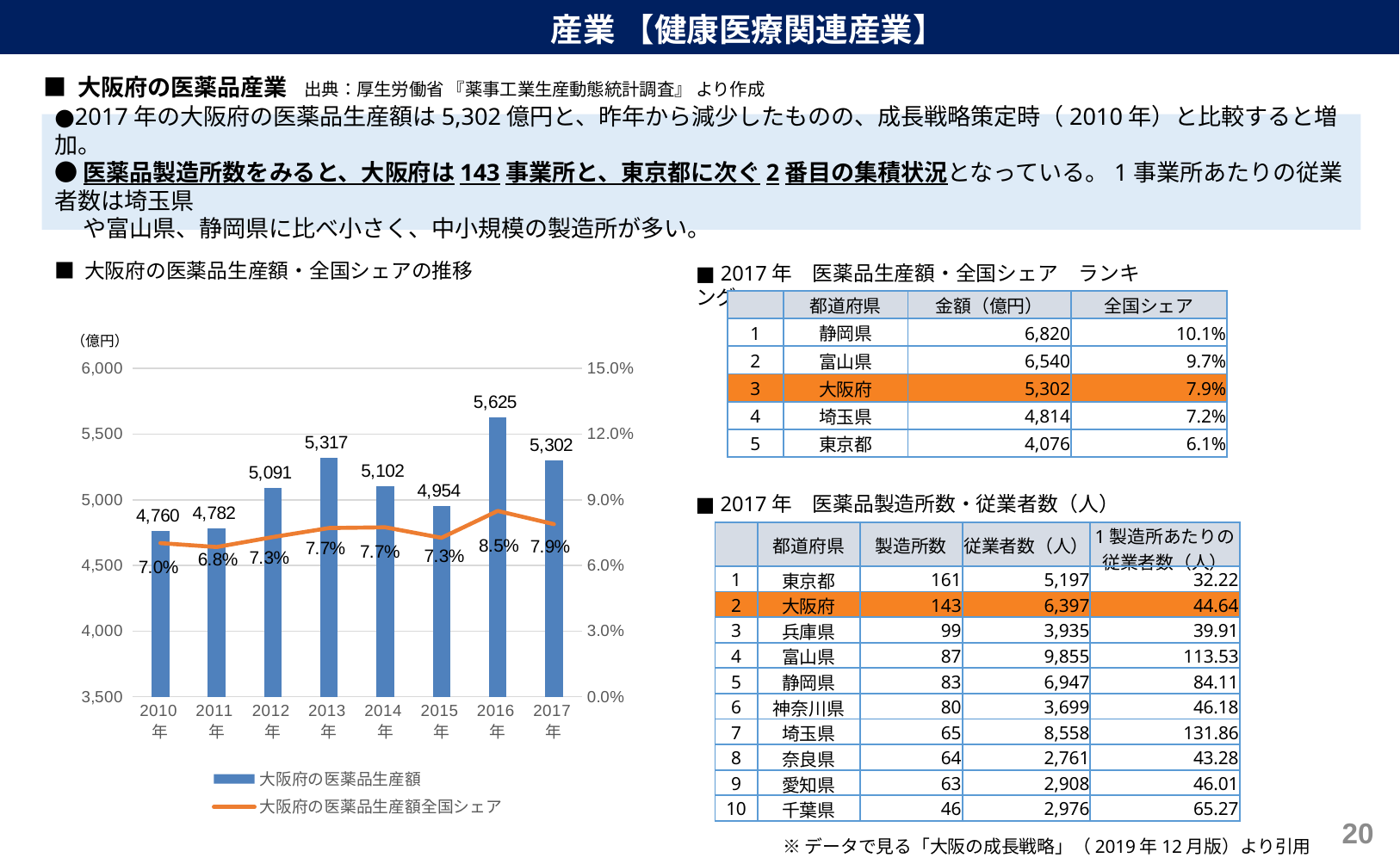
In the chart 大阪府の医薬品生産額・全国シェアの推移, what kind of chart is used for 大阪府の医薬品生産額? bar chart In the chart 大阪府の医薬品生産額・全国シェアの推移, what unit is shown above the left axis? 億円 In the chart 大阪府の医薬品生産額・全国シェアの推移, which year has the highest 大阪府の医薬品生産額? 2016年 In the chart 大阪府の医薬品生産額・全国シェアの推移, how many years are shown on the x axis? 8 In the chart 大阪府の医薬品生産額・全国シェアの推移, which is larger, the 大阪府の医薬品生産額 for 2013年 or for 2014年? 2013年 In the chart 大阪府の医薬品生産額・全国シェアの推移, how many series does the legend list? 2 In the chart 大阪府の医薬品生産額・全国シェアの推移, what is the 全国シェア value for 2011年? 6.8% In the chart 大阪府の医薬品生産額・全国シェアの推移, which year has the lowest 大阪府の医薬品生産額? 2010年 In the chart 大阪府の医薬品生産額・全国シェアの推移, what is the difference in 大阪府の医薬品生産額 between 2016年 and 2017年? 323 In the chart 大阪府の医薬品生産額・全国シェアの推移, does 大阪府の医薬品生産額 rise or fall from 2010年 to 2013年? rise In the chart 大阪府の医薬品生産額・全国シェアの推移, which year has the lowest 全国シェア? 2011年 In the chart 大阪府の医薬品生産額・全国シェアの推移, what is the value of 大阪府の医薬品生産額 for 2016年? 5,625